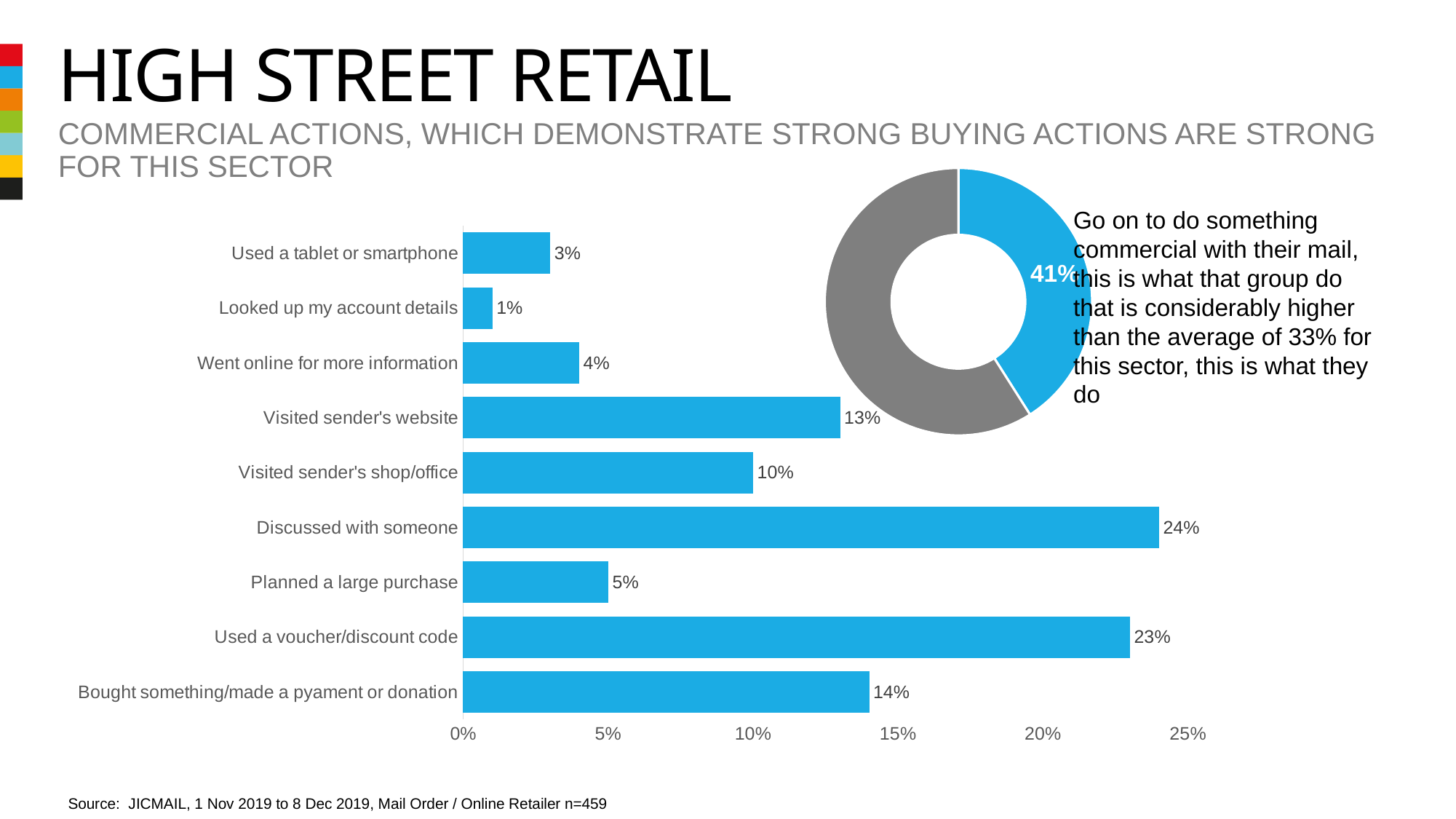
In the bar chart, is the value for 'Used a voucher/discount code' greater or less than 20%? greater In the bar chart, what is the difference between 'Used a voucher/discount code' and 'Visited sender's shop/office'? 13% In the bar chart, what is the value for 'Discussed with someone'? 24% In the bar chart, which is larger: 'Planned a large purchase' or 'Went online for more information'? Planned a large purchase In the bar chart, what is the value for 'Bought something/made a pyament or donation'? 14% What kind of chart is the chart on the left of the slide? bar chart What kind of chart is the chart in the upper right of the slide? donut chart How many categories does the bar chart show? 9 In the donut chart, what share is shown for the blue segment? 41% In the bar chart, what is the value for 'Visited sender's website'? 13% In the bar chart, which category has the highest value? Discussed with someone In the bar chart, which category has the lowest value? Looked up my account details